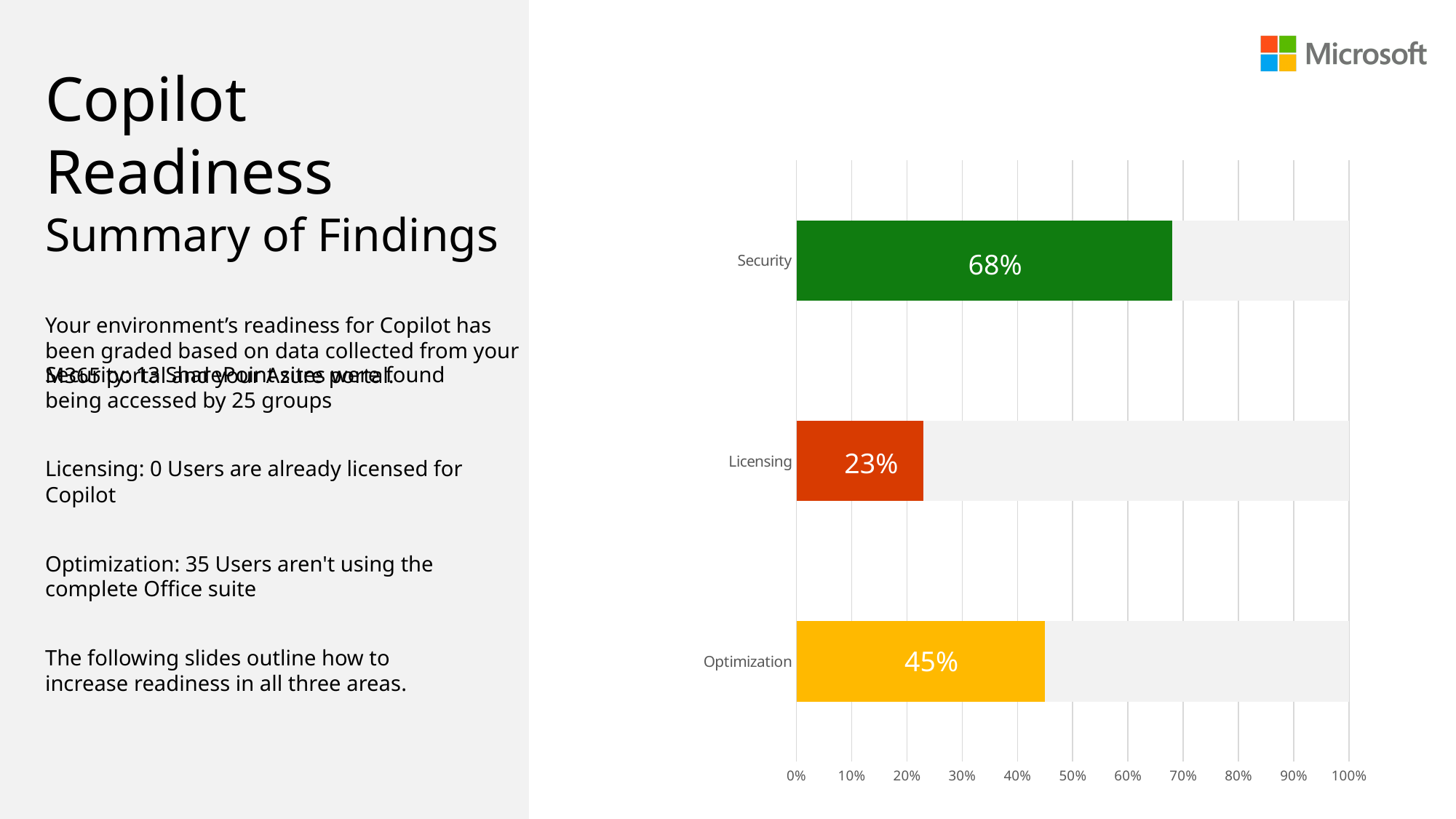
Which category has the lowest value? Licensing What colour is the Licensing bar? red Which category has the highest value? Security Is the value for Security greater or less than 50%? greater What is the difference between the Security and Licensing values? 45% What is the value for Security? 68% What is the value for Licensing? 23% Which is larger, the value for Optimization or the value for Licensing? Optimization What is the difference between the Optimization and Licensing values? 22% How many categories are shown in the chart? 3 What is the value for Optimization? 45% What kind of chart is shown on the slide? bar chart